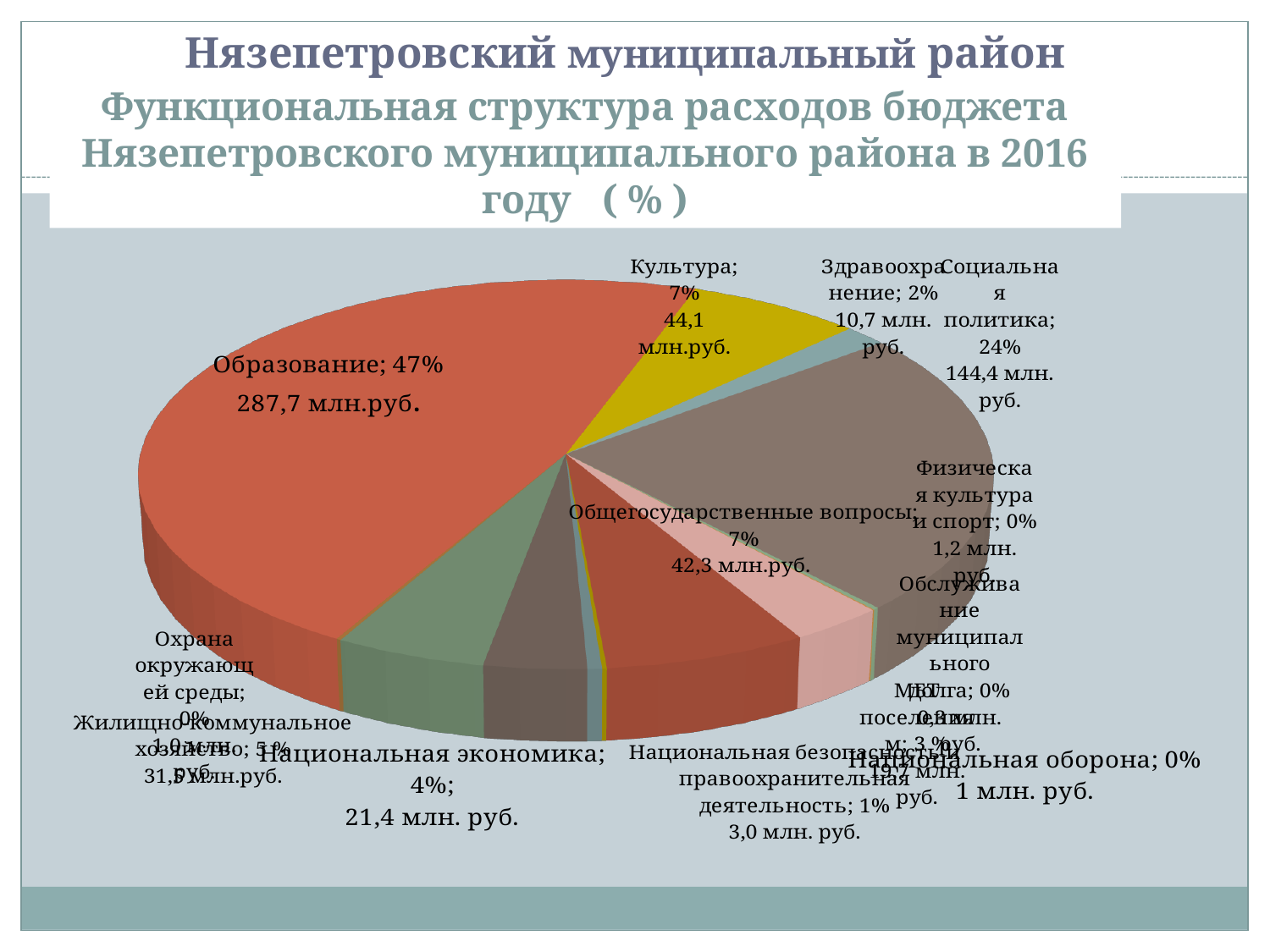
What is the amount in million rubles for Культура? 44,1 млн.руб. What is the amount in million rubles for Общегосударственные вопросы? 42,3 млн.руб. Which is larger, the share for Социальная политика or the share for Культура? Социальная политика What share of the budget expenditure goes to Образование? 47% What is the amount in million rubles for Социальная политика? 144,4 млн. руб. What kind of chart is shown on the slide? pie chart What percentage is shown for Здравоохранение? 2% What share of the pie does Социальная политика take? 24% What is the amount in million rubles for Образование? 287,7 млн.руб. What is the difference in million rubles between Образование and Социальная политика? 143,3 млн. руб. What is the amount in million rubles for Национальная экономика? 21,4 млн. руб. Which category has the largest share of the pie? Образование